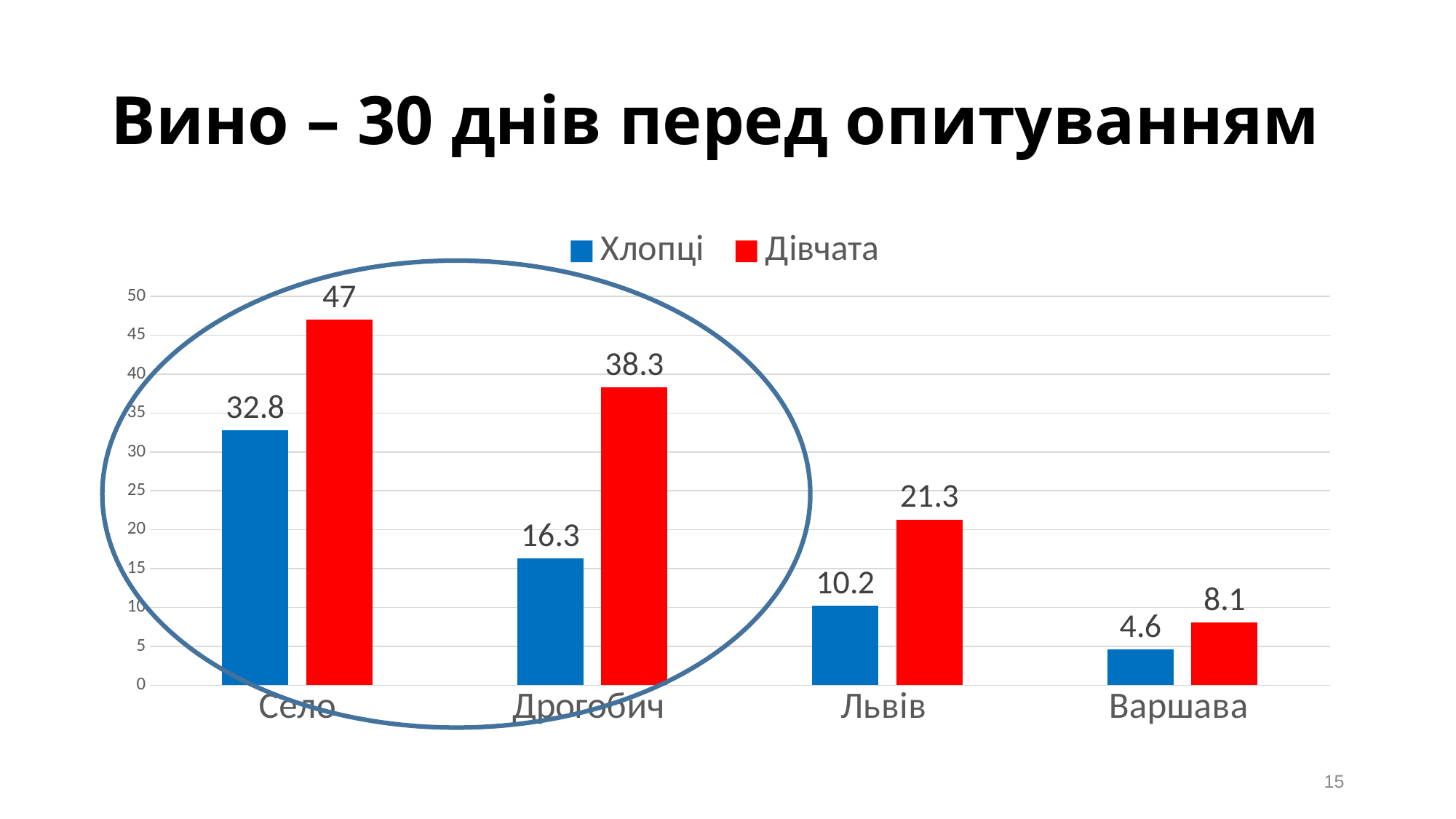
What is the value for Дівчата in Дрогобич? 38.3 What is the title of the chart? Вино – 30 днів перед опитуванням What is the difference between the Дівчата and Хлопці values in Львів? 11.1 Which is larger: the Хлопці value in Село or the Дівчата value in Дрогобич? Дівчата in Дрогобич How many categories are shown on the x axis? 4 What is the value for Хлопці in Село? 32.8 What is the value for Хлопці in Варшава? 4.6 How many series does the legend list? 2 What kind of chart is shown on the slide? bar chart Which category has the highest value for Дівчата? Село Is the value for Дівчата in Варшава greater or less than 10? less Which category has the lowest value for Хлопці? Варшава